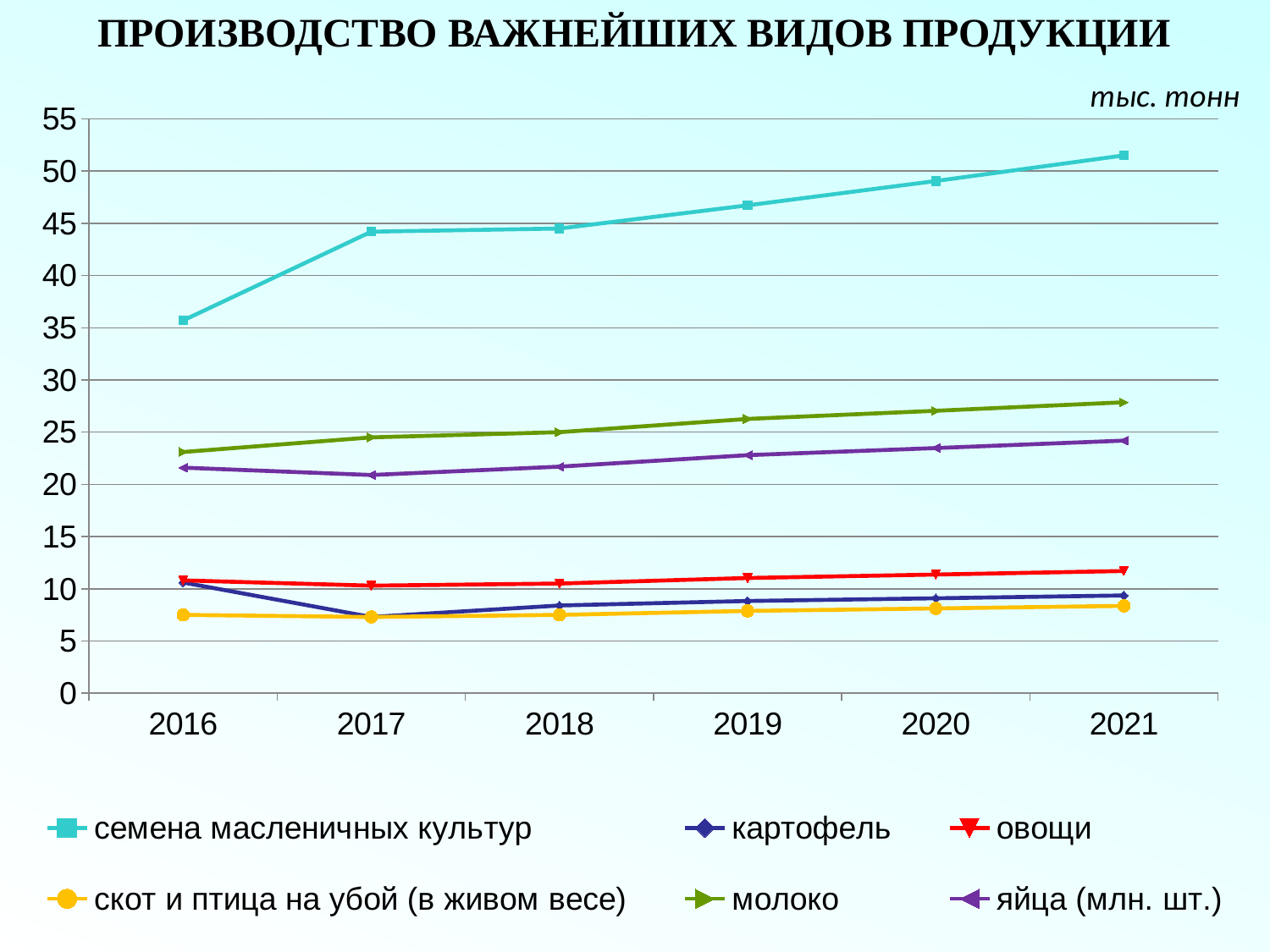
Which series has the highest value in 2021? семена масленичных культур Is the value for семена масленичных культур in 2021 greater or less than 50? greater What unit is shown above the chart? тыс. тонн Which series has the lowest value in 2021? скот и птица на убой (в живом весе) How many series does the legend list? 6 Is the value for молоко in 2016 greater or less than 25? less Does the value for семена масленичных культур rise or fall from 2016 to 2021? rise What kind of chart is shown on the slide? line chart Which is larger in 2019, молоко or яйца (млн. шт.)? молоко Is the value for семена масленичных культур in 2016 greater or less than 40? less Does the value for картофель rise or fall from 2016 to 2017? fall How many years are shown along the x axis? 6